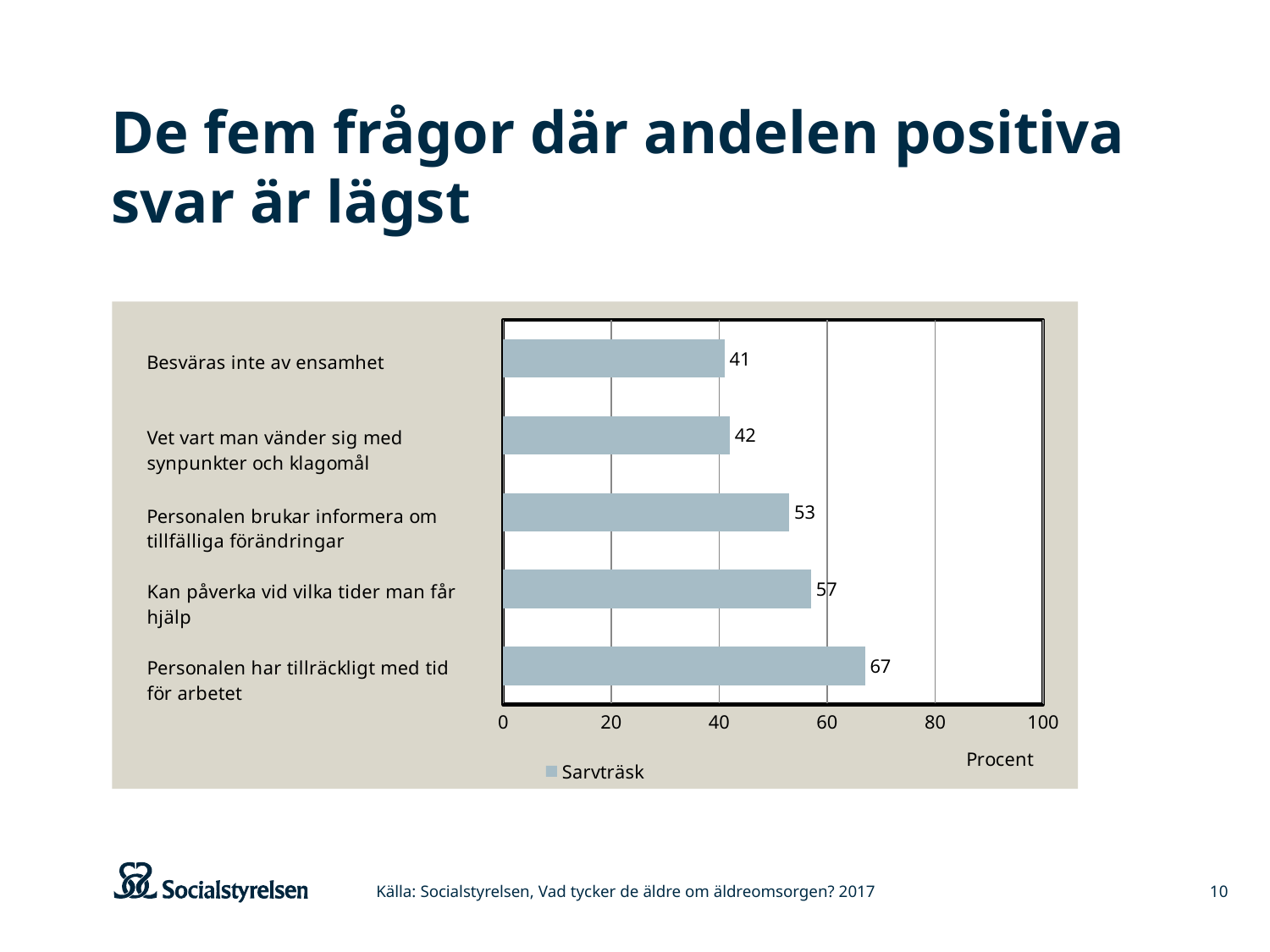
What series name is shown in the legend? Sarvträsk What is the value for "Personalen har tillräckligt med tid för arbetet"? 67 How many categories are shown in the chart? 5 Is the value for "Vet vart man vänder sig med synpunkter och klagomål" greater or less than 60? less Which category has the lowest value? Besväras inte av ensamhet Which is larger: the value for "Kan påverka vid vilka tider man får hjälp" or for "Personalen brukar informera om tillfälliga förändringar"? Kan påverka vid vilka tider man får hjälp Which category has the highest value? Personalen har tillräckligt med tid för arbetet What is the value for "Besväras inte av ensamhet"? 41 What kind of chart is shown on the slide? bar chart What is the difference between the values for "Personalen har tillräckligt med tid för arbetet" and "Besväras inte av ensamhet"? 26 What is the value for "Personalen brukar informera om tillfälliga förändringar"? 53 How many series does the legend list? 1